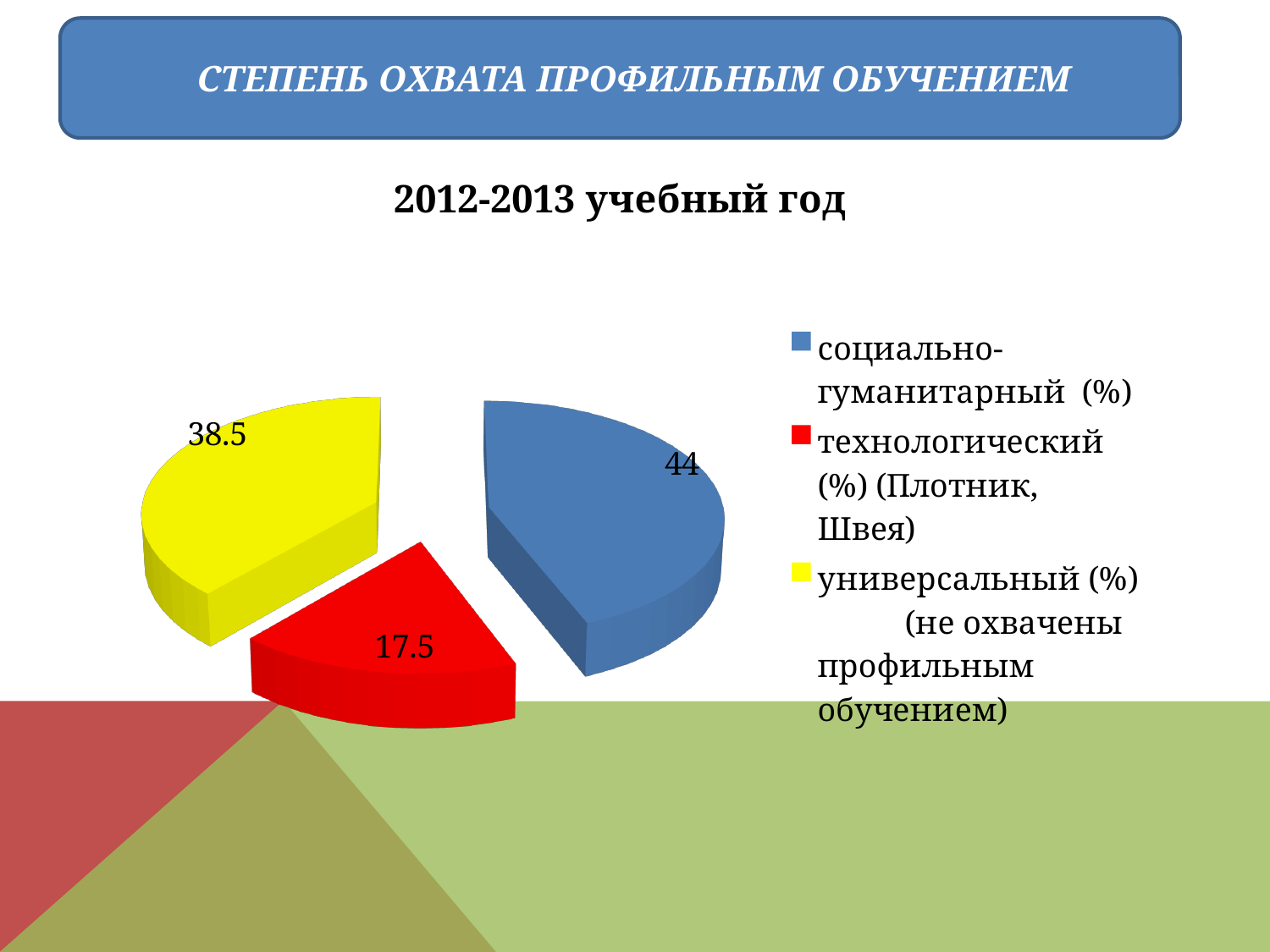
What is the value for универсальный (%)? 38.5 What colour is the slice for технологический (%) (Плотник, Швея)? red What is the value for социально-гуманитарный (%)? 44 What is the value for технологический (%) (Плотник, Швея)? 17.5 What kind of chart is shown on the slide? pie chart Which category has the largest slice of the pie? социально-гуманитарный (%) Which is larger, the value for универсальный or the value for технологический? универсальный What is the difference between the values for универсальный and технологический? 21 Which category has the smallest slice of the pie? технологический (%) (Плотник, Швея) What is the difference between the values for социально-гуманитарный and универсальный? 5.5 What academic year is shown above the chart? 2012-2013 учебный год How many slices does the pie chart have? 3